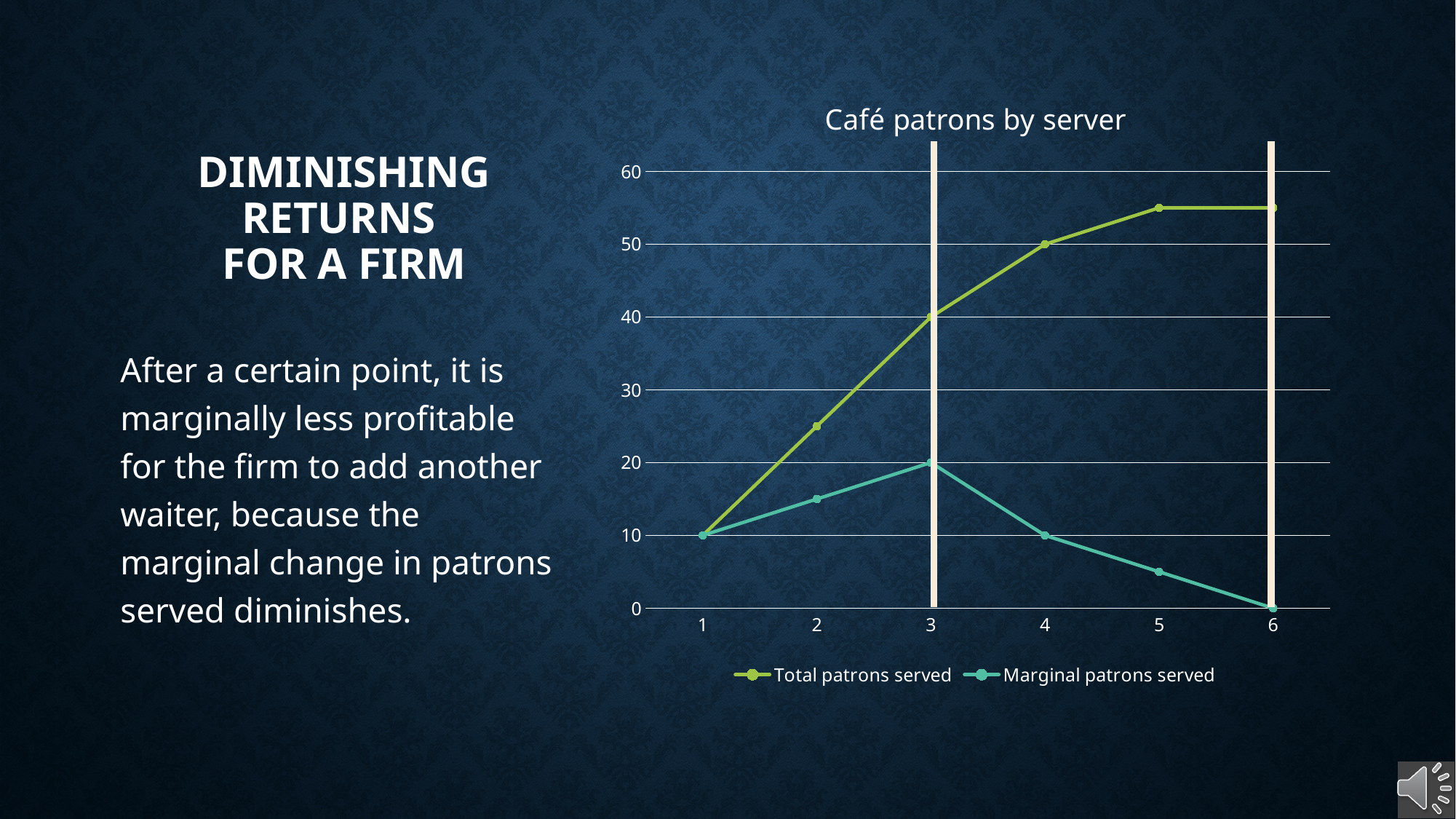
How many series does the legend list? 2 At which server number is Marginal patrons served highest? 3 What kind of chart is shown on the slide? line chart What is the value of Marginal patrons served at server 6? 0 What is the value of Total patrons served at server 3? 40 What is the value of Marginal patrons served at server 3? 20 How many points are plotted along the x axis for each series? 6 What is the difference between Total patrons served and Marginal patrons served at server 3? 20 Is the value for Total patrons served at server 2 greater or less than 30? less What is the title of the chart? Café patrons by server What is the value of Total patrons served at server 4? 50 Is the value for Total patrons served at server 5 greater or less than 50? greater